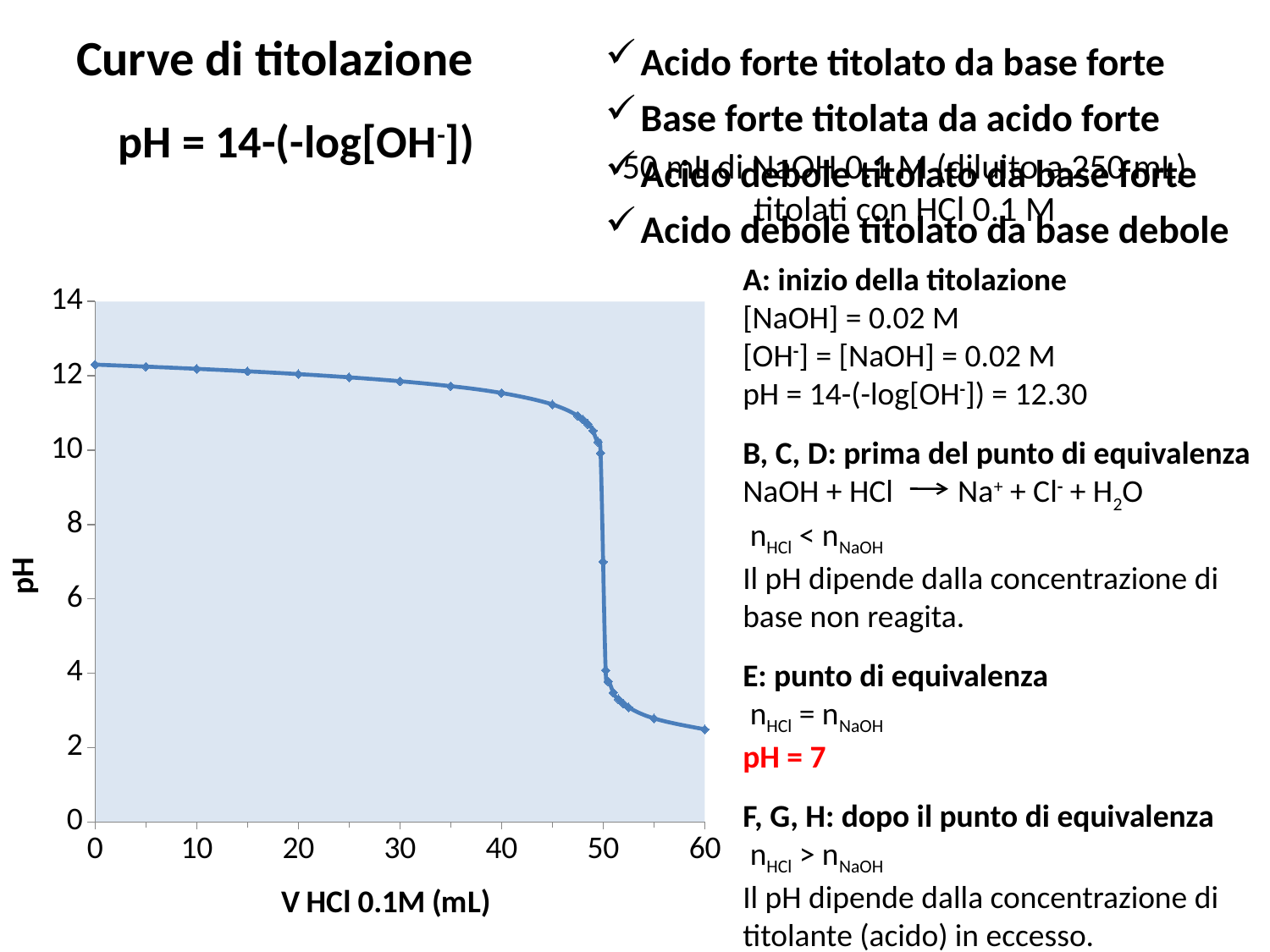
Is the pH at 40 mL of HCl greater or less than 10? greater What kind of chart is shown on the slide? line chart Around which volume of HCl does the curve drop most steeply? 50 mL Does the pH rise or fall as the volume of HCl increases along the x axis? fall Is the pH at 55 mL of HCl greater or less than 4? less Which has the higher pH on the curve: 10 mL of HCl or 60 mL of HCl? 10 mL Is the pH at 60 mL of HCl greater or less than 4? less What is the title of the x axis of the chart? V HCl 0.1M (mL) What is the highest value shown on the y axis of the chart? 14